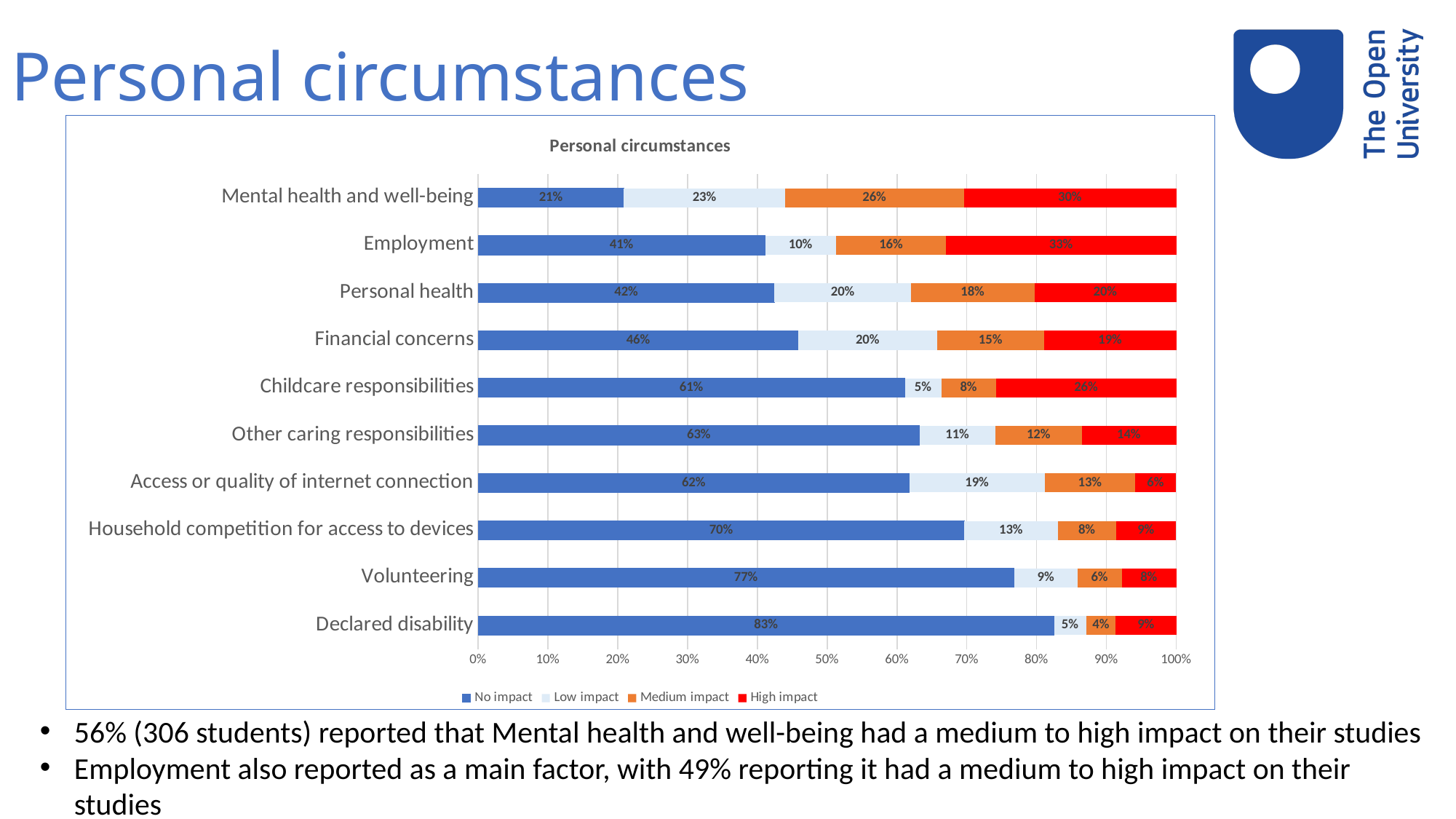
What kind of chart is shown on the slide? Stacked bar chart Which has a larger High impact value, Childcare responsibilities or Other caring responsibilities? Childcare responsibilities What is the title of the chart? Personal circumstances What is the difference between the High impact values for Employment and Personal health? 13% What is the Low impact value for Access or quality of internet connection? 19% What is the High impact value for Mental health and well-being? 30% Which category has the lowest No impact value? Mental health and well-being Which category has the highest No impact value? Declared disability How many series does the chart legend list? 4 What is the Medium impact value for Financial concerns? 15% What is the No impact value for Employment? 41% How many personal circumstance categories are plotted in the chart? 10